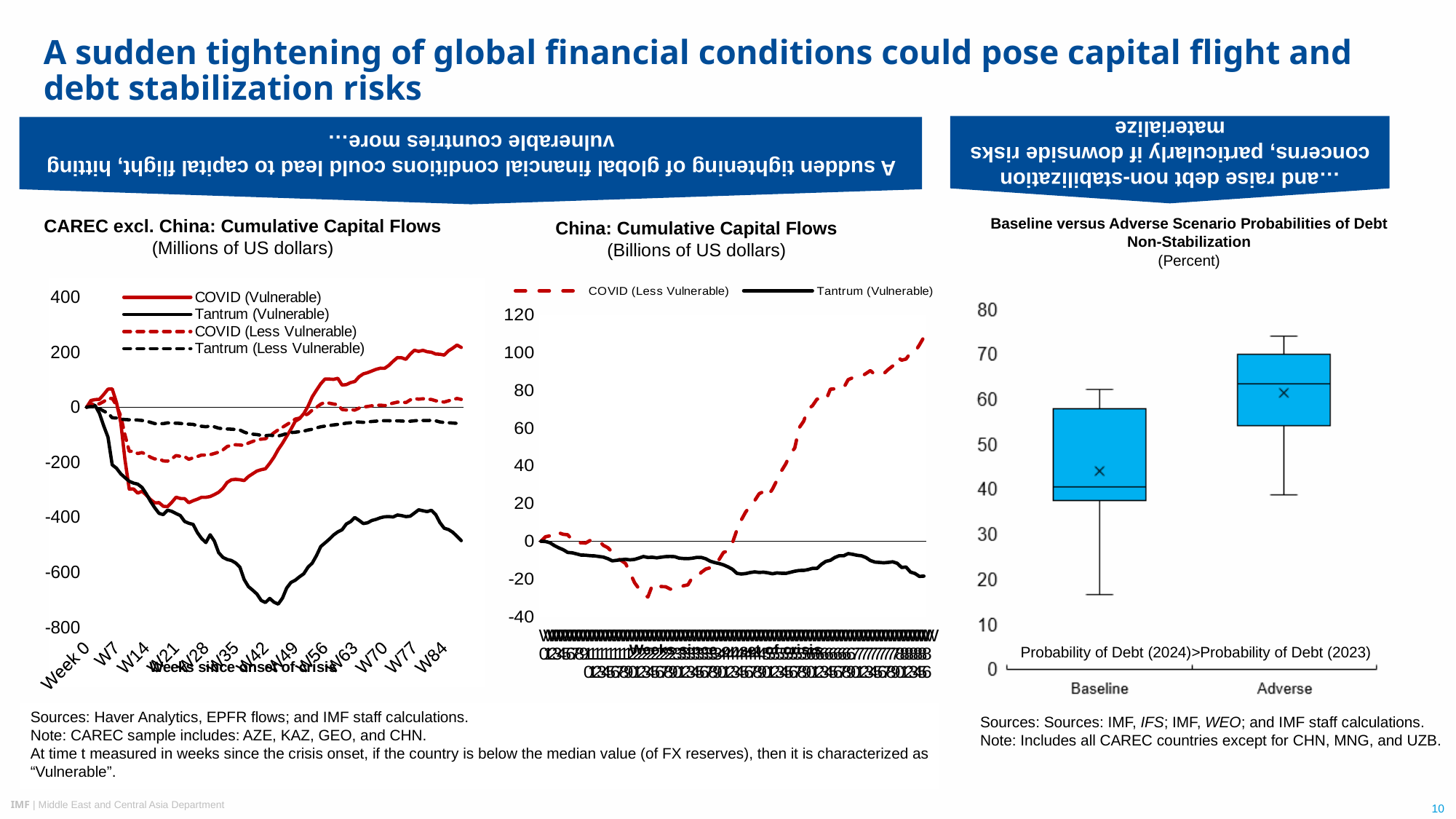
In 'China: Cumulative Capital Flows', does the COVID (Less Vulnerable) line rise or fall over the second half of the period? rise What kind of chart is 'CAREC excl. China: Cumulative Capital Flows'? line chart In 'China: Cumulative Capital Flows', is the final value of the Tantrum (Vulnerable) line greater or less than 0? less In 'Baseline versus Adverse Scenario Probabilities of Debt Non-Stabilization', is the lowest whisker value for Baseline greater or less than 20? less In 'Baseline versus Adverse Scenario Probabilities of Debt Non-Stabilization', which scenario has the higher median? Adverse In 'China: Cumulative Capital Flows', is the final value of the COVID (Less Vulnerable) line greater or less than 80? greater In 'CAREC excl. China: Cumulative Capital Flows', which line is lower at W42: COVID (Vulnerable) or Tantrum (Vulnerable)? Tantrum (Vulnerable) How many series does the legend of 'CAREC excl. China: Cumulative Capital Flows' list? 4 How many series does the legend of 'China: Cumulative Capital Flows' list? 2 What kind of chart is 'Baseline versus Adverse Scenario Probabilities of Debt Non-Stabilization'? box plot